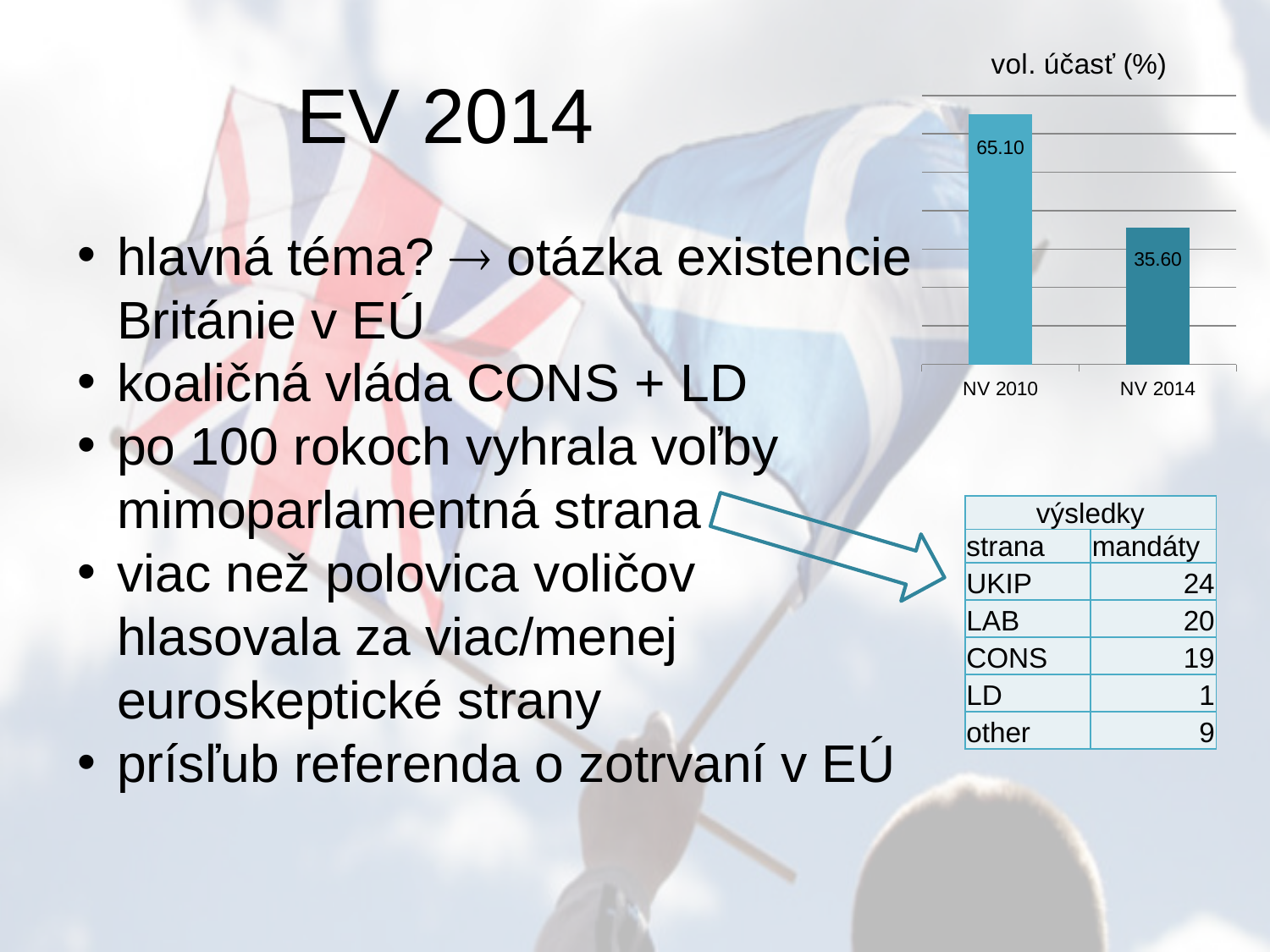
Which category has the highest value in the chart? NV 2010 How many categories are shown in the chart? 2 What is the value for NV 2014 in the chart? 35.60 What is the difference between the values for NV 2010 and NV 2014? 29.50 What is the title of the chart? vol. účasť (%) Which category has the lowest value in the chart? NV 2014 What kind of chart is shown on the slide? bar chart What is the value for NV 2010 in the chart? 65.10 Do the values rise or fall from NV 2010 to NV 2014? fall Which is larger, the value for NV 2010 or the value for NV 2014? NV 2010